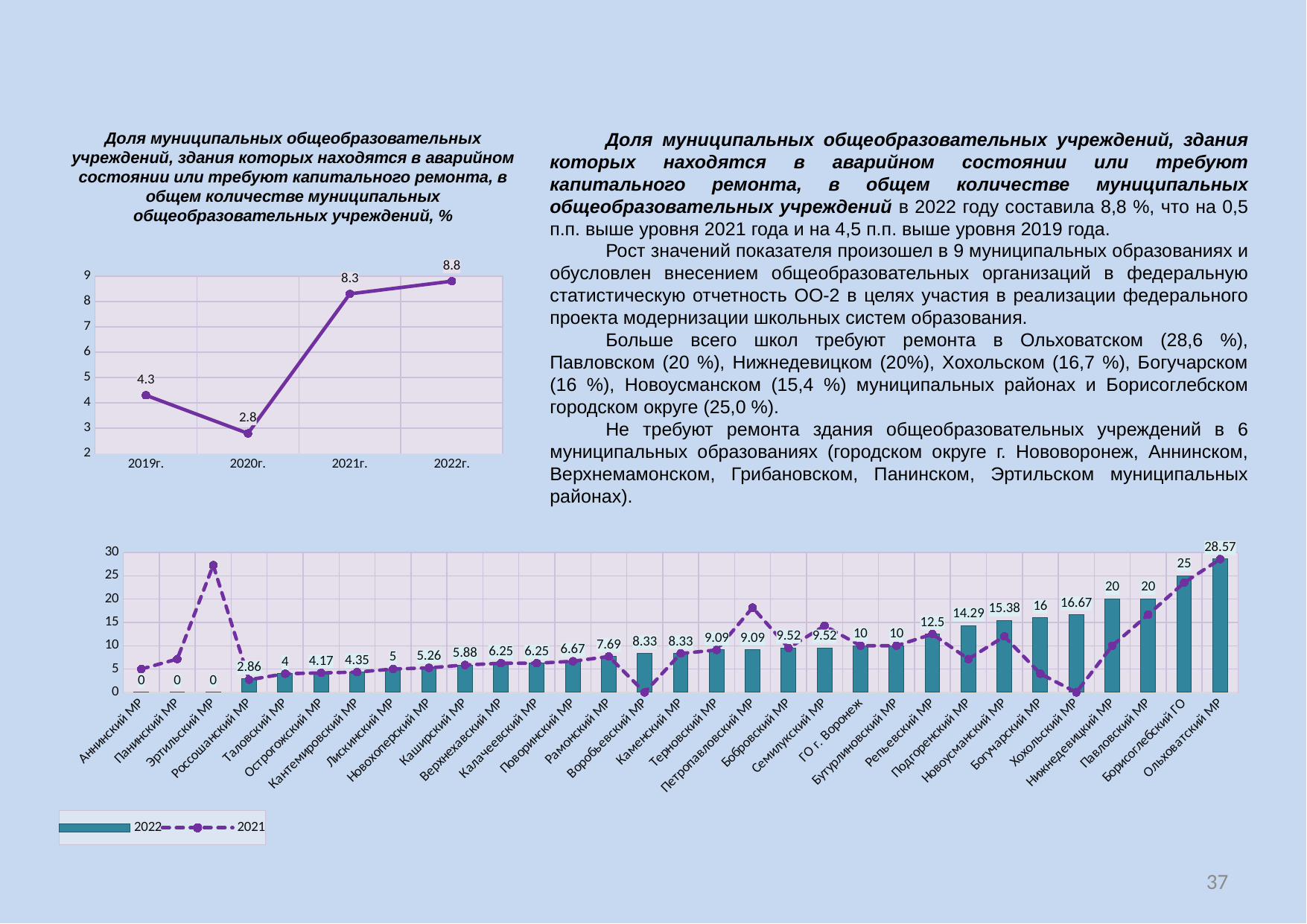
In the bottom chart, what is the 2022 value for Новоусманский МР? 15.38 In the bottom chart, what is the 2022 value for Ольховатский МР? 28.57 In the top-left line chart, what is the value for 2020г.? 2.8 In the top-left line chart, how many data points are plotted? 4 In the top-left line chart, what is the value for 2022г.? 8.8 In the bottom chart, what is the difference between the 2022 values for Борисоглебский ГО and Павловский МР? 5 In the bottom chart, how many series does the legend list? 2 In the bottom chart, which category has the highest 2022 value? Ольховатский МР In the top-left line chart, which year has the lowest value? 2020г. In the top-left line chart, what is the difference between the 2021г. and 2019г. values? 4 In the bottom chart, which is larger for 2022: Богучарский МР or Хохольский МР? Хохольский МР In the bottom chart, is the 2021 value for Эртильский МР greater or less than 20? greater